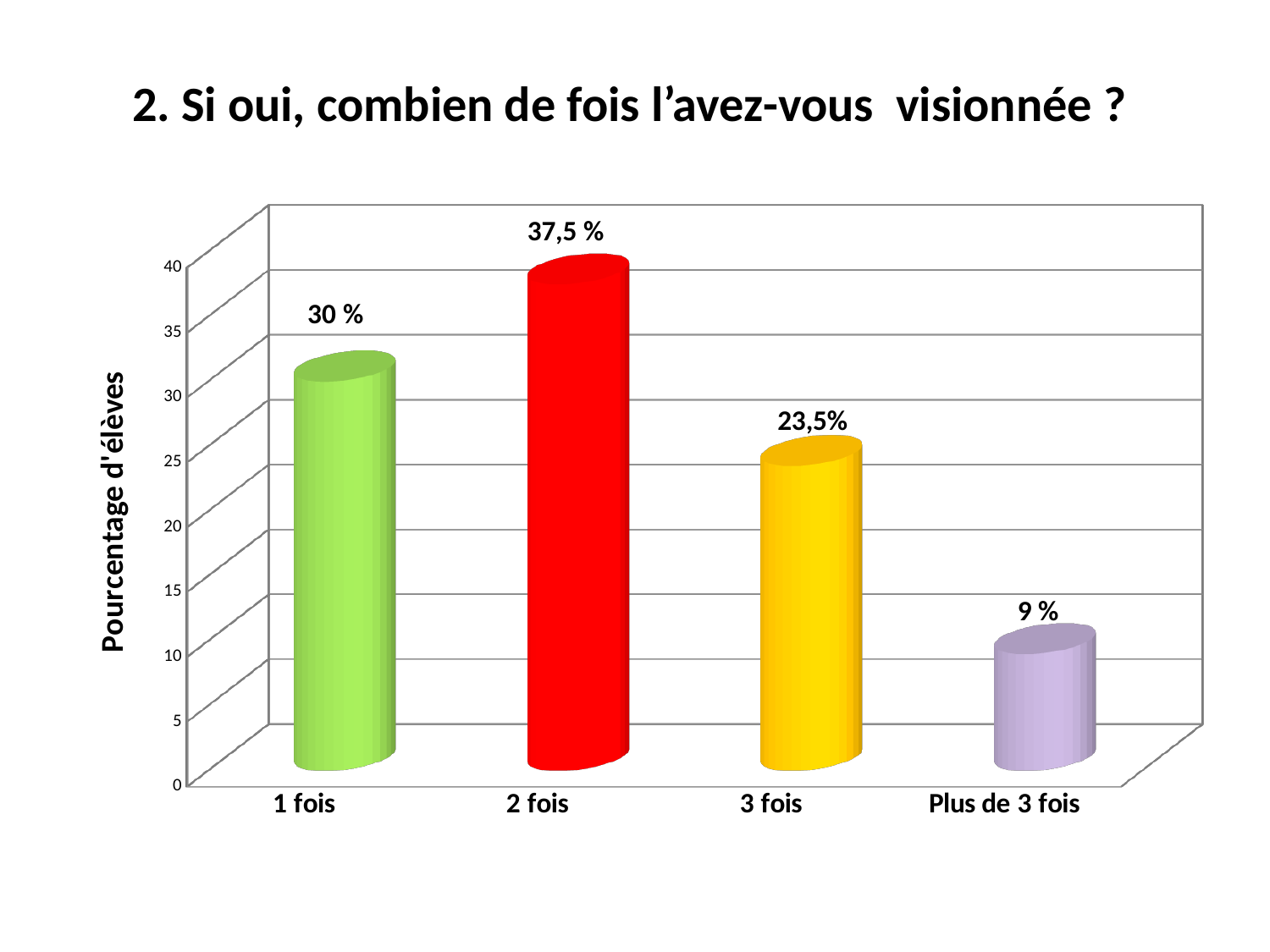
Which category has the lowest value? Plus de 3 fois What is the value for "2 fois"? 37,5 % What is the value for "3 fois"? 23,5% What is the value for "Plus de 3 fois"? 9 % What kind of chart is shown on the slide? Bar chart What is the label of the vertical axis? Pourcentage d'élèves Which is larger, the value for "1 fois" or the value for "3 fois"? 1 fois What is the value for "1 fois"? 30 % How many categories are shown on the x axis? 4 What colour is the bar for "2 fois"? Red Which category has the highest value? 2 fois What is the difference between the values for "2 fois" and "1 fois"? 7,5 %